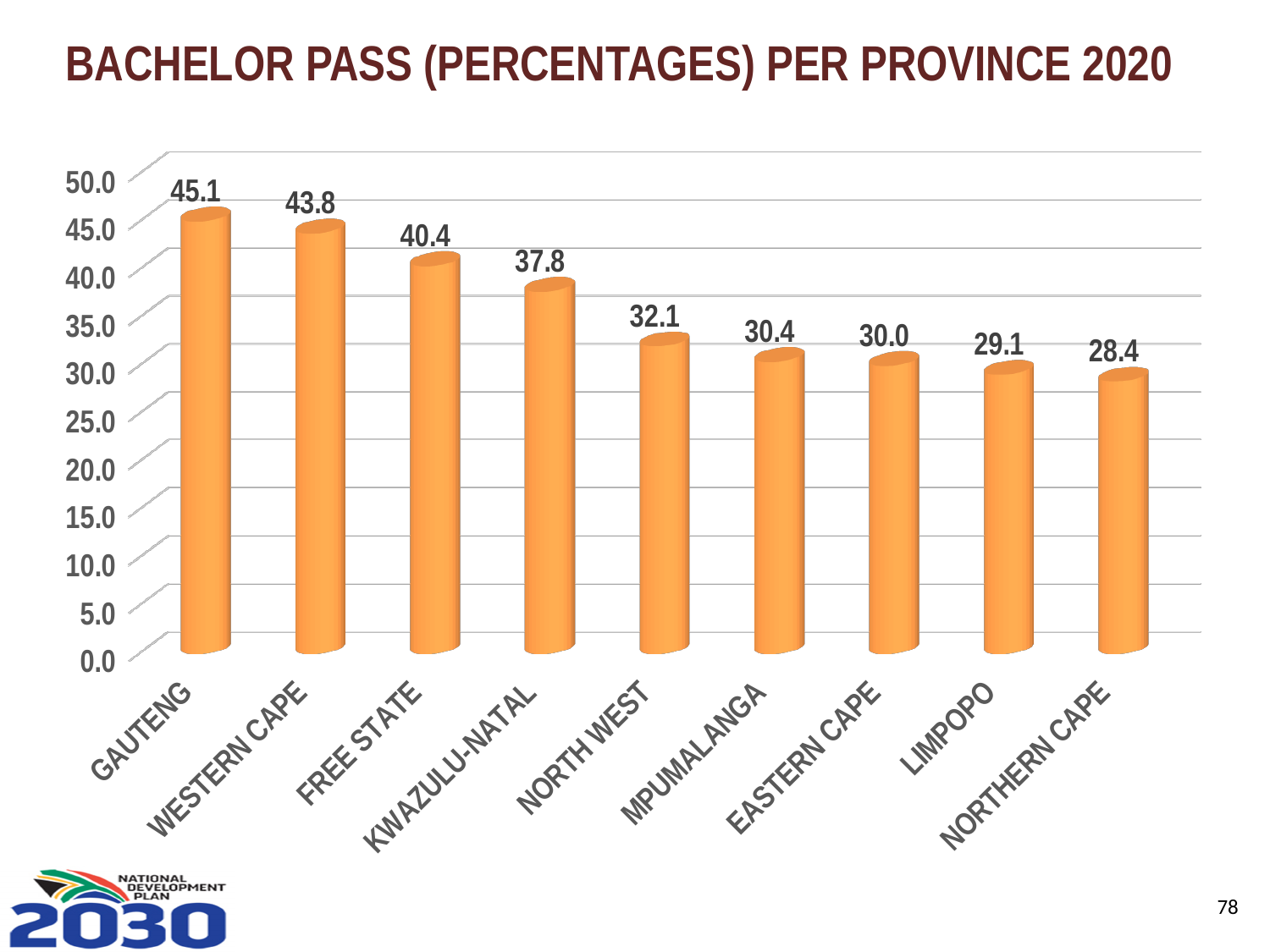
How many provinces are shown in the chart? 9 Which province has the lowest bachelor pass percentage? Northern Cape Is the bachelor pass percentage for Eastern Cape greater or less than 35.0? less What is the bachelor pass percentage for KwaZulu-Natal? 37.8 What is the difference between the bachelor pass percentages of Western Cape and Free State? 3.4 What is the difference between the bachelor pass percentages of Gauteng and Northern Cape? 16.7 Which province has the highest bachelor pass percentage? Gauteng Which has a higher bachelor pass percentage, North West or Mpumalanga? North West What kind of chart is shown on the slide? bar chart Do the values rise or fall from left to right along the x axis? fall What is the bachelor pass percentage for Limpopo? 29.1 What is the bachelor pass percentage for Gauteng? 45.1